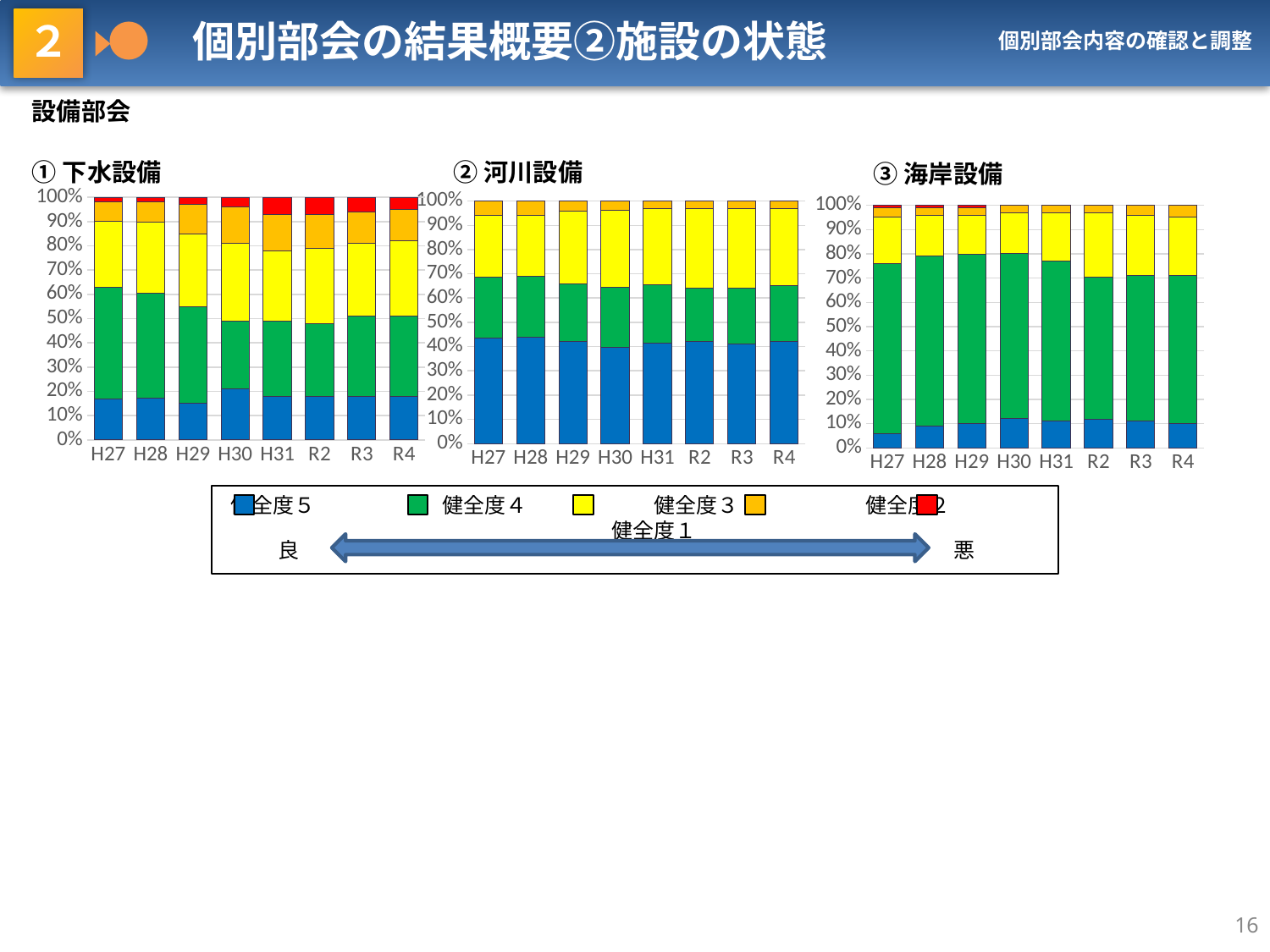
In the ② 河川設備 chart, is the 健全度5 share for H27 greater or less than 30%? greater What is the title of the leftmost chart? ① 下水設備 In the ③ 海岸設備 chart, is the 健全度5 share for H27 greater or less than 10%? less Which colour represents 健全度4 in the legend? green What kind of chart is the ① 下水設備 chart? stacked bar chart How many series does the shared legend list? 5 In the ① 下水設備 chart, which year has the largest 健全度5 share? H30 How many years (categories) are shown on the x axis of the ② 河川設備 chart? 8 In the ③ 海岸設備 chart, is the 健全度4 share for H27 greater or less than 50%? greater In the ③ 海岸設備 chart, which year has the smallest 健全度5 share? H27 For H27, is the 健全度5 share larger in the ② 河川設備 chart or the ③ 海岸設備 chart? ② 河川設備